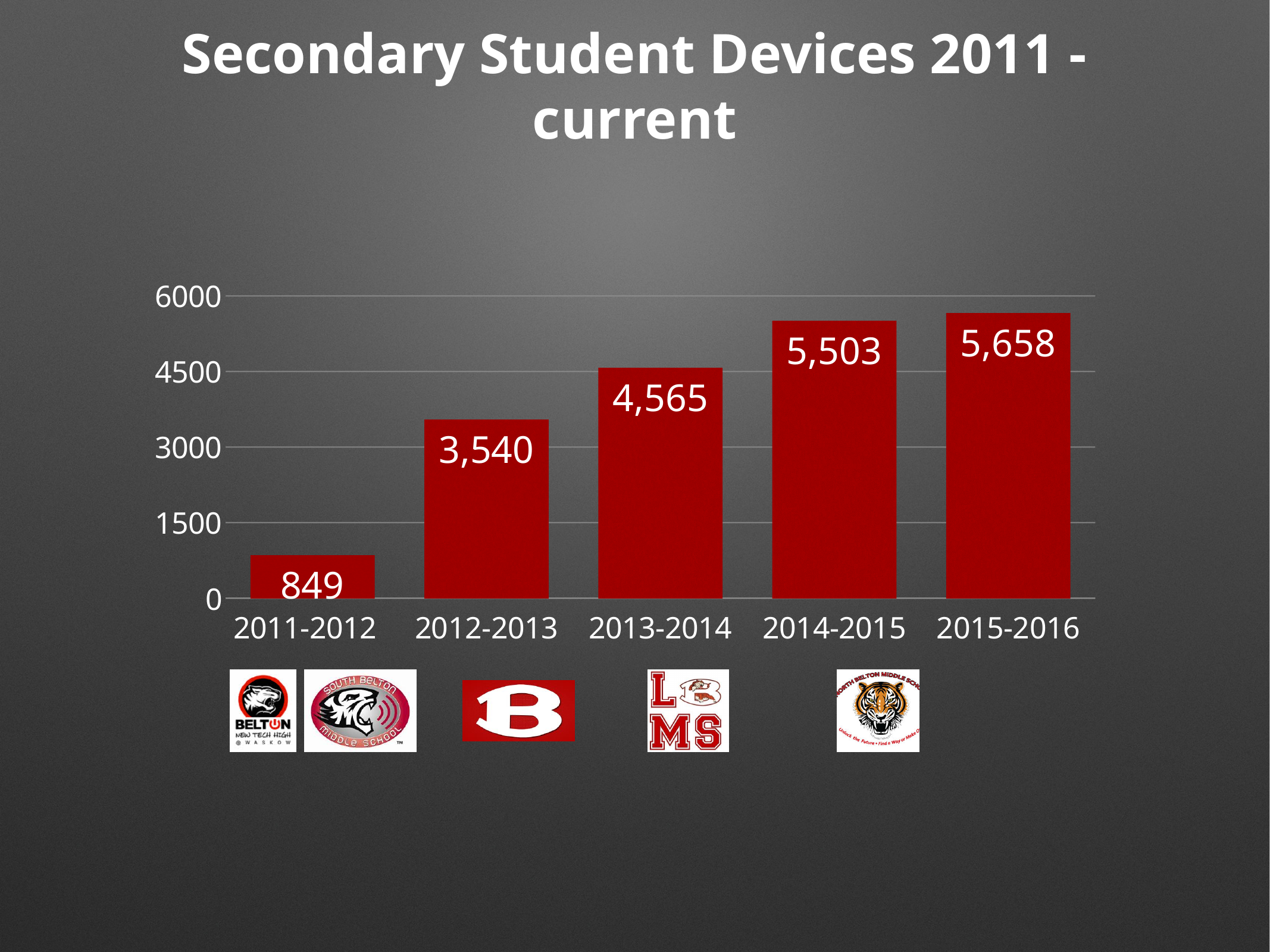
What is the value for 2011-2012? 849 What is the difference between the values for 2015-2016 and 2014-2015? 155 What kind of chart is shown on the slide? bar chart What is the value for 2013-2014? 4,565 What is the difference between the values for 2012-2013 and 2011-2012? 2,691 Which school year has the lowest number of devices? 2011-2012 Which school year has the highest number of devices? 2015-2016 What is the value for 2015-2016? 5,658 How many school years are shown on the chart? 5 Which is larger, the value for 2013-2014 or the value for 2012-2013? 2013-2014 Is the value for 2014-2015 greater or less than 4500? greater Do the values rise or fall from 2011-2012 to 2015-2016? rise